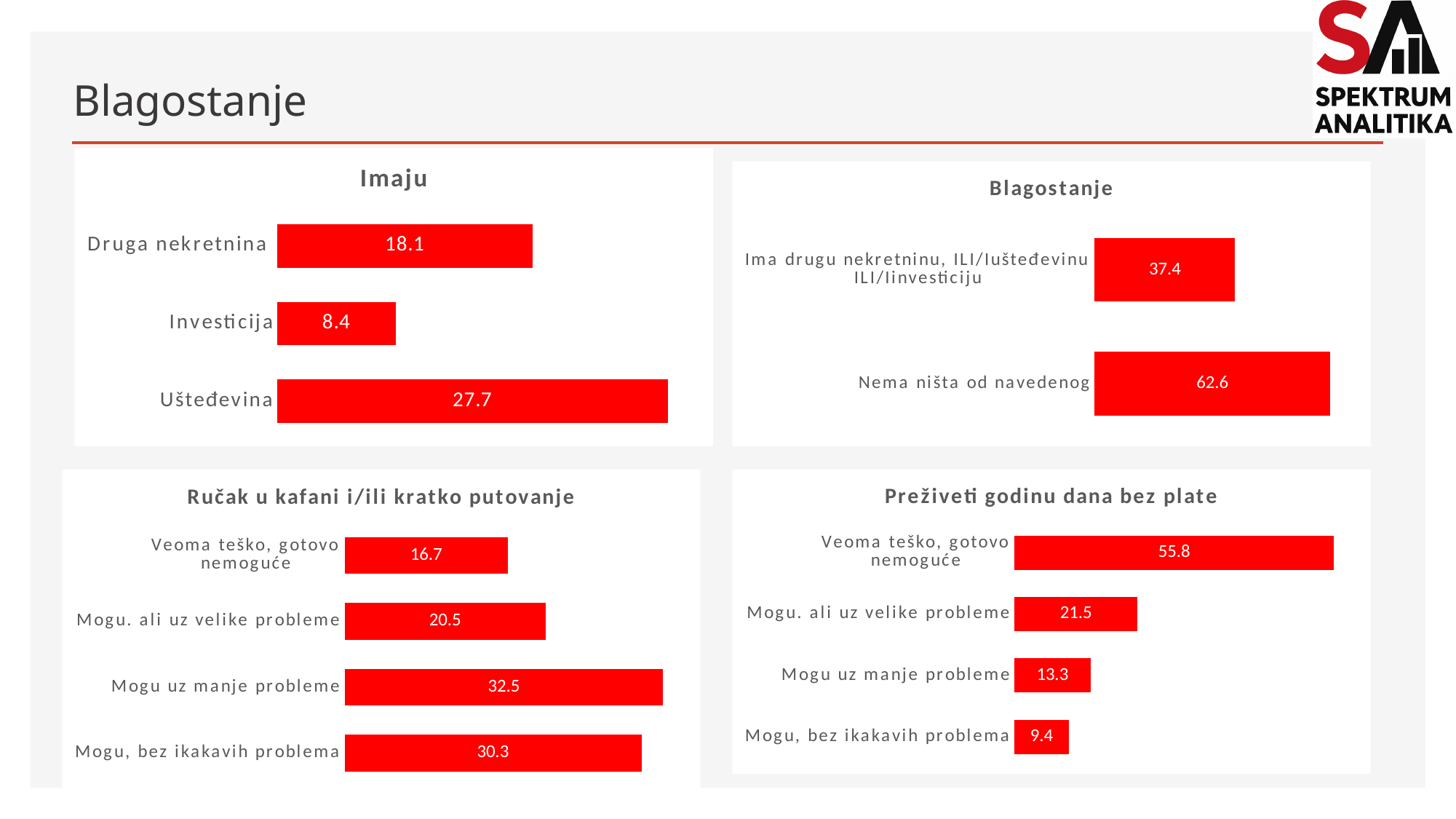
In the 'Imaju' chart, what is the value for Ušteđevina? 27.7 In the 'Preživeti godinu dana bez plate' chart, which is larger: 'Mogu uz manje probleme' or 'Mogu, bez ikakavih problema'? Mogu uz manje probleme In the 'Preživeti godinu dana bez plate' chart, do the values rise or fall from the top category to the bottom? fall In the 'Preživeti godinu dana bez plate' chart, what is the value for 'Veoma teško, gotovo nemoguće'? 55.8 In the 'Blagostanje' chart (top right), what is the total of the two values? 100 In the 'Blagostanje' chart (top right), how many categories are shown? 2 In the 'Ručak u kafani i/ili kratko putovanje' chart, what is the value for 'Mogu. ali uz velike probleme'? 20.5 What type of chart is the 'Imaju' chart? bar chart In the 'Blagostanje' chart (top right), what is the value for 'Nema ništa od navedenog'? 62.6 In the 'Imaju' chart, what is the difference between Ušteđevina and Druga nekretnina? 9.6 In the 'Imaju' chart, which category has the lowest value? Investicija In the 'Ručak u kafani i/ili kratko putovanje' chart, which category has the highest value? Mogu uz manje probleme